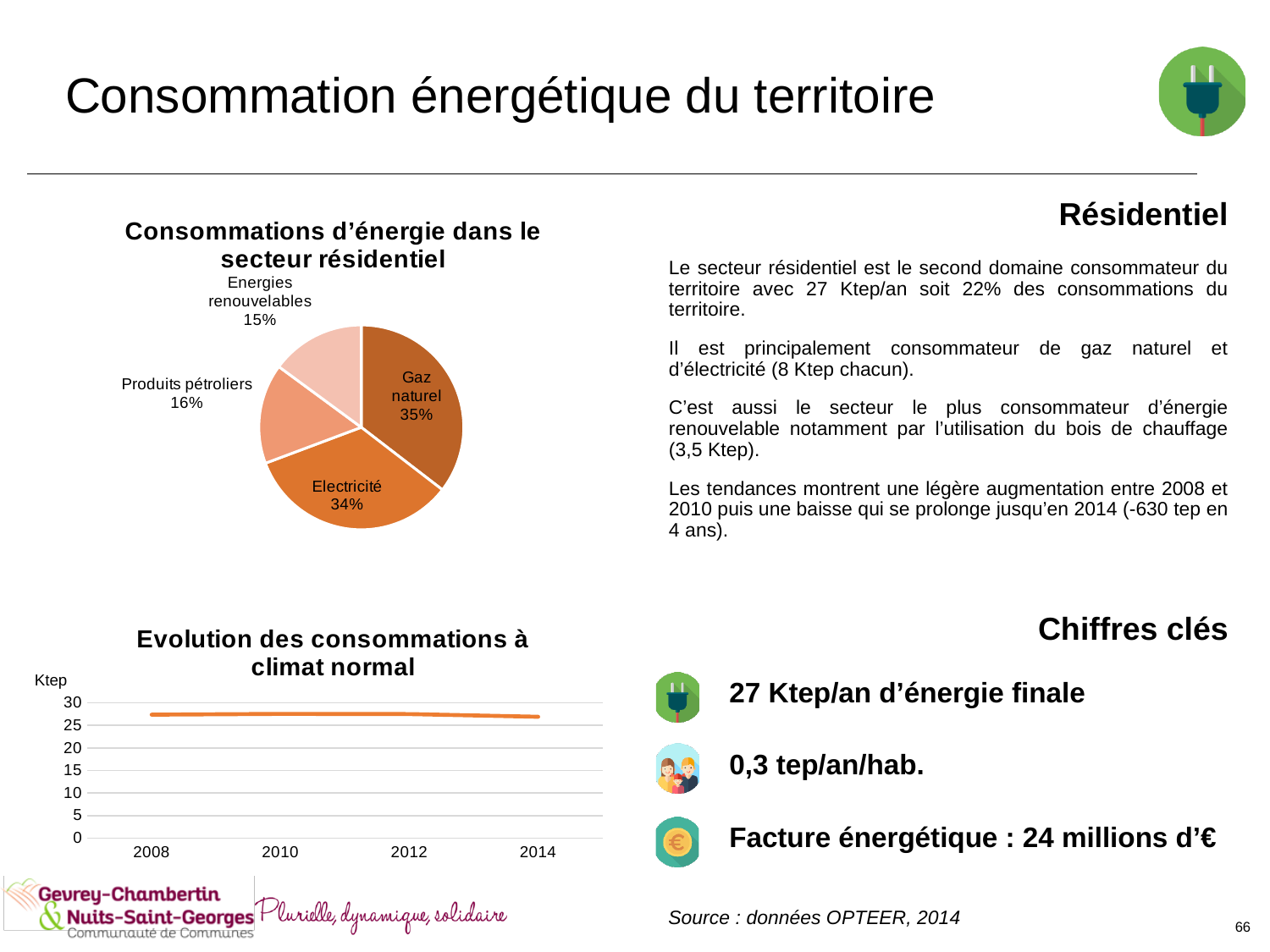
In the pie chart 'Consommations d'énergie dans le secteur résidentiel', how many categories are shown? 4 In the pie chart 'Consommations d'énergie dans le secteur résidentiel', what share do Energies renouvelables have? 15% In the pie chart 'Consommations d'énergie dans le secteur résidentiel', which category has the smallest share? Energies renouvelables In the chart 'Evolution des consommations à climat normal', what unit is shown on the y axis? Ktep In the pie chart 'Consommations d'énergie dans le secteur résidentiel', how many percentage points larger is Gaz naturel than Produits pétroliers? 19 What kind of chart is 'Consommations d'énergie dans le secteur résidentiel'? Pie chart In the pie chart 'Consommations d'énergie dans le secteur résidentiel', what share does Gaz naturel have? 35% In the chart 'Evolution des consommations à climat normal', is the value for 2008 greater or less than 25? greater In the pie chart 'Consommations d'énergie dans le secteur résidentiel', what share does Electricité have? 34% In the pie chart 'Consommations d'énergie dans le secteur résidentiel', which category has the largest share? Gaz naturel What kind of chart is 'Evolution des consommations à climat normal'? Line chart In the pie chart 'Consommations d'énergie dans le secteur résidentiel', what share do Produits pétroliers have? 16%